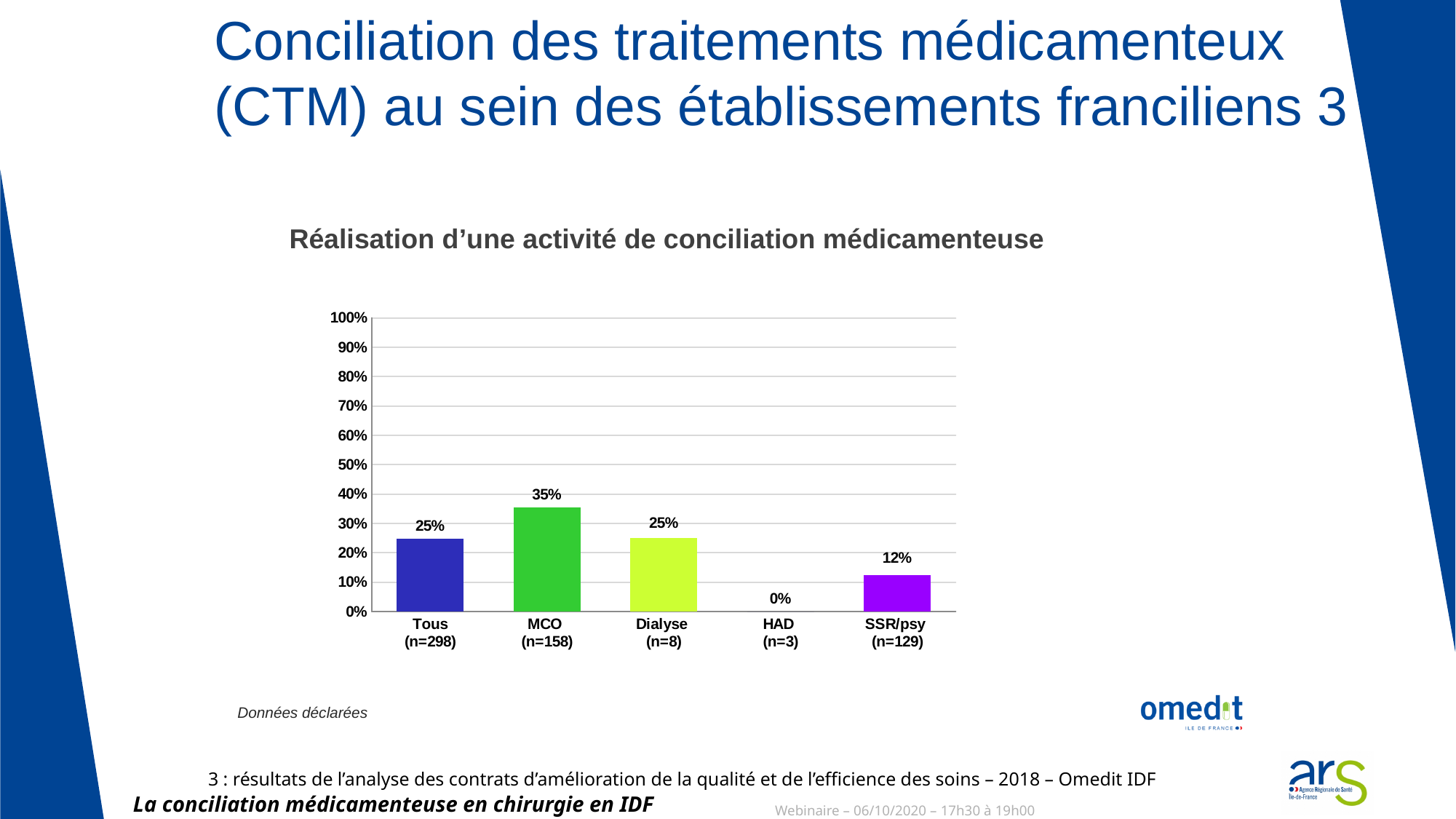
Which category has the lowest value? HAD (n=3) What is the value for MCO (n=158)? 35% Which category has the highest value? MCO (n=158) What is the difference between the values for MCO and SSR/psy? 23% What is the title of the chart? Réalisation d'une activité de conciliation médicamenteuse How many categories are shown on the x axis? 5 What is the value for HAD (n=3)? 0% Which is larger, the value for Dialyse or the value for SSR/psy? Dialyse Is the value for MCO greater or less than 30%? greater What kind of chart is shown on the slide? bar chart What is the value for SSR/psy (n=129)? 12% What is the value for Tous (n=298)? 25%